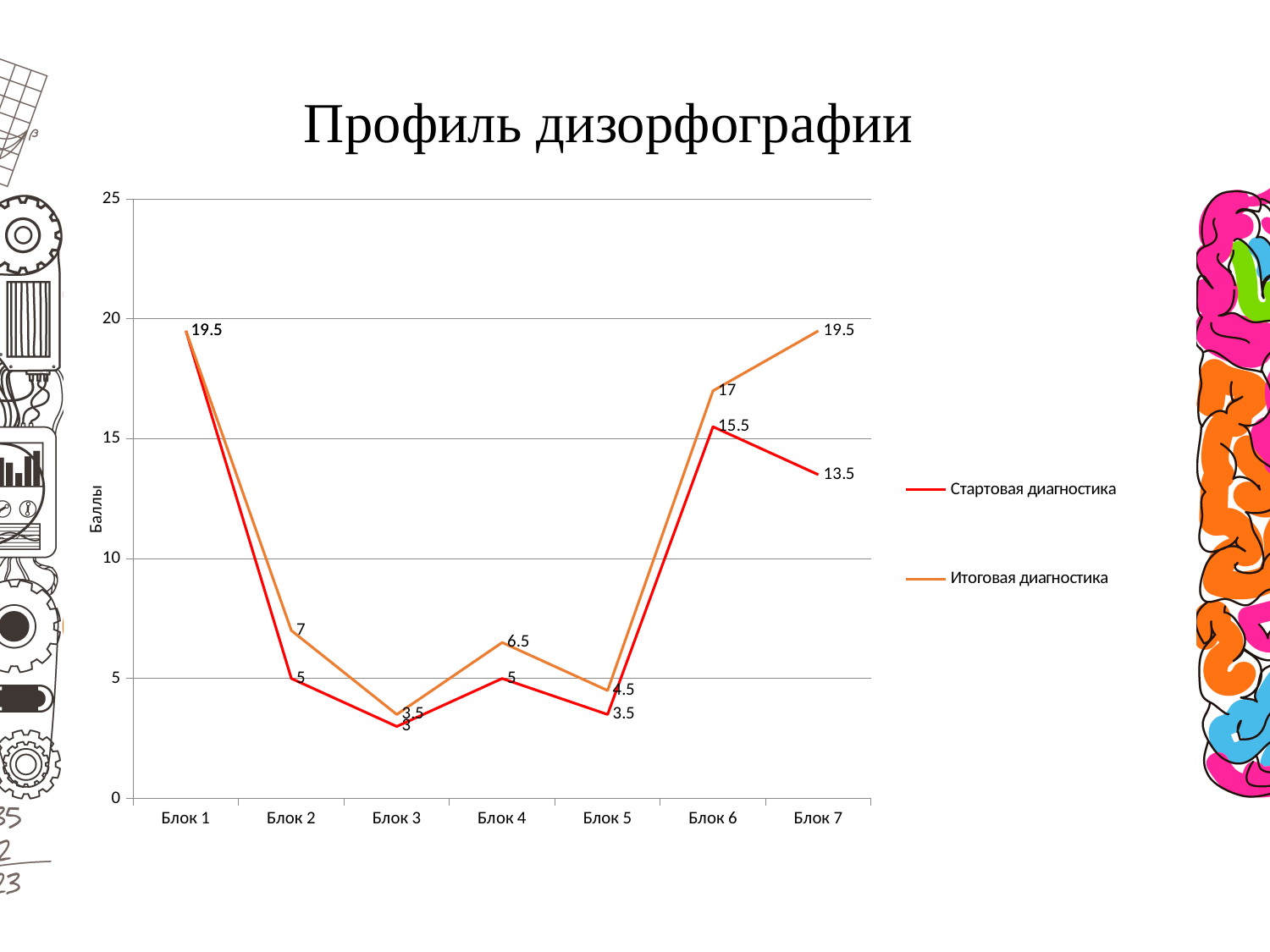
What is the value for Стартовая диагностика at Блок 7? 13.5 How many series does the legend list? 2 How many categories (blocks) are shown on the x axis? 7 What is the value for Стартовая диагностика at Блок 6? 15.5 Which block has the lowest value for Стартовая диагностика? Блок 3 What is the title of the chart? Профиль дизорфографии What type of chart is shown on the slide? line chart Which series has the larger value at Блок 4, Стартовая диагностика or Итоговая диагностика? Итоговая диагностика Is the value for Итоговая диагностика at Блок 6 greater or less than 15? greater What is the value for Итоговая диагностика at Блок 2? 7 What is the value for Итоговая диагностика at Блок 7? 19.5 What is the difference between Итоговая диагностика and Стартовая диагностика at Блок 7? 6